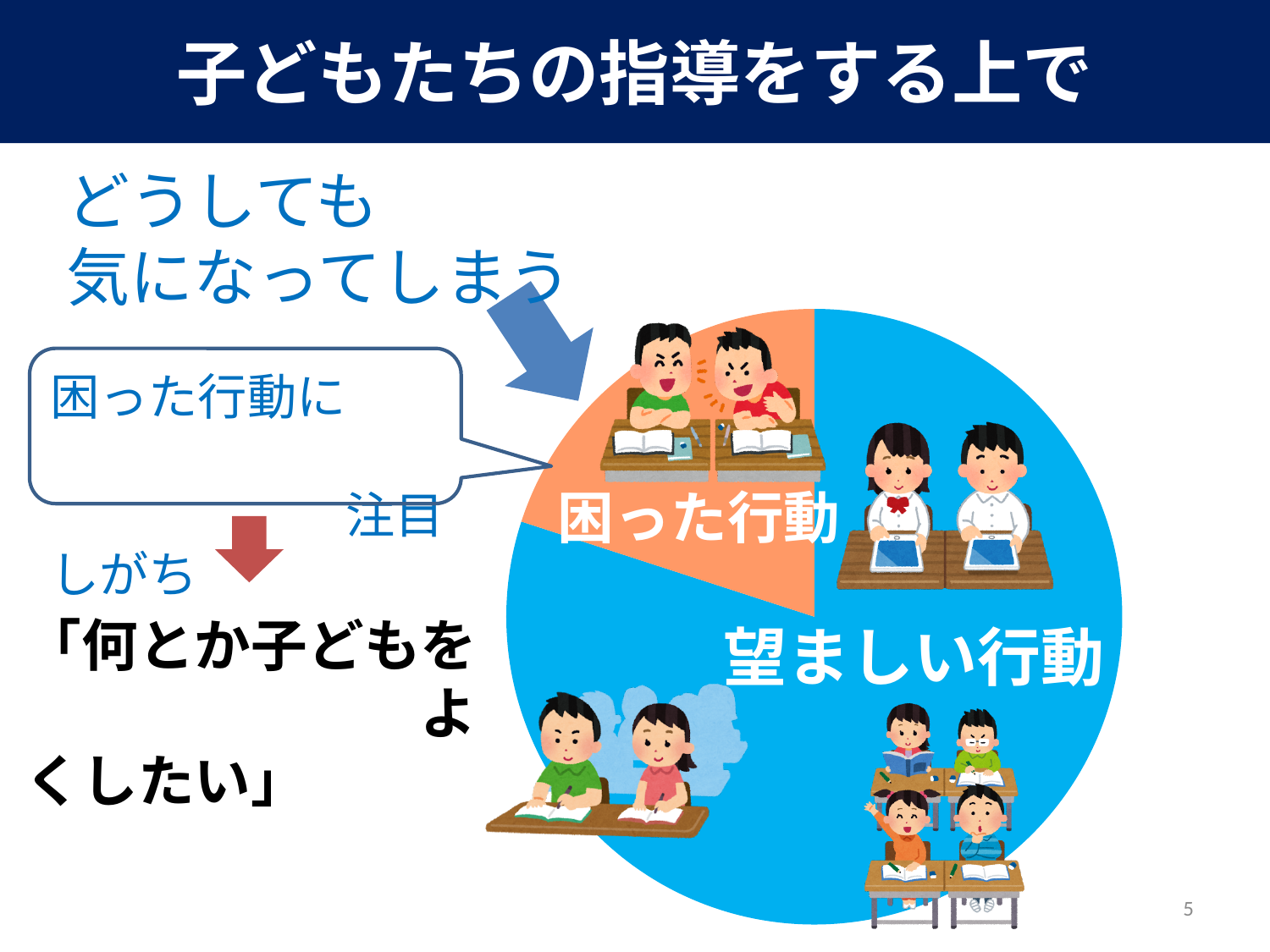
What colour is the 望ましい行動 slice of the pie chart? blue Which slice of the pie chart is the smallest? 困った行動 Is the 困った行動 slice more or less than half of the pie chart? less What colour is the 困った行動 slice of the pie chart? orange What kind of chart is shown on the slide? pie chart Which slice of the pie chart is the largest? 望ましい行動 How many slices does the pie chart have? 2 Which slice is larger, 困った行動 or 望ましい行動? 望ましい行動 Is the 望ましい行動 slice more or less than half of the pie chart? more